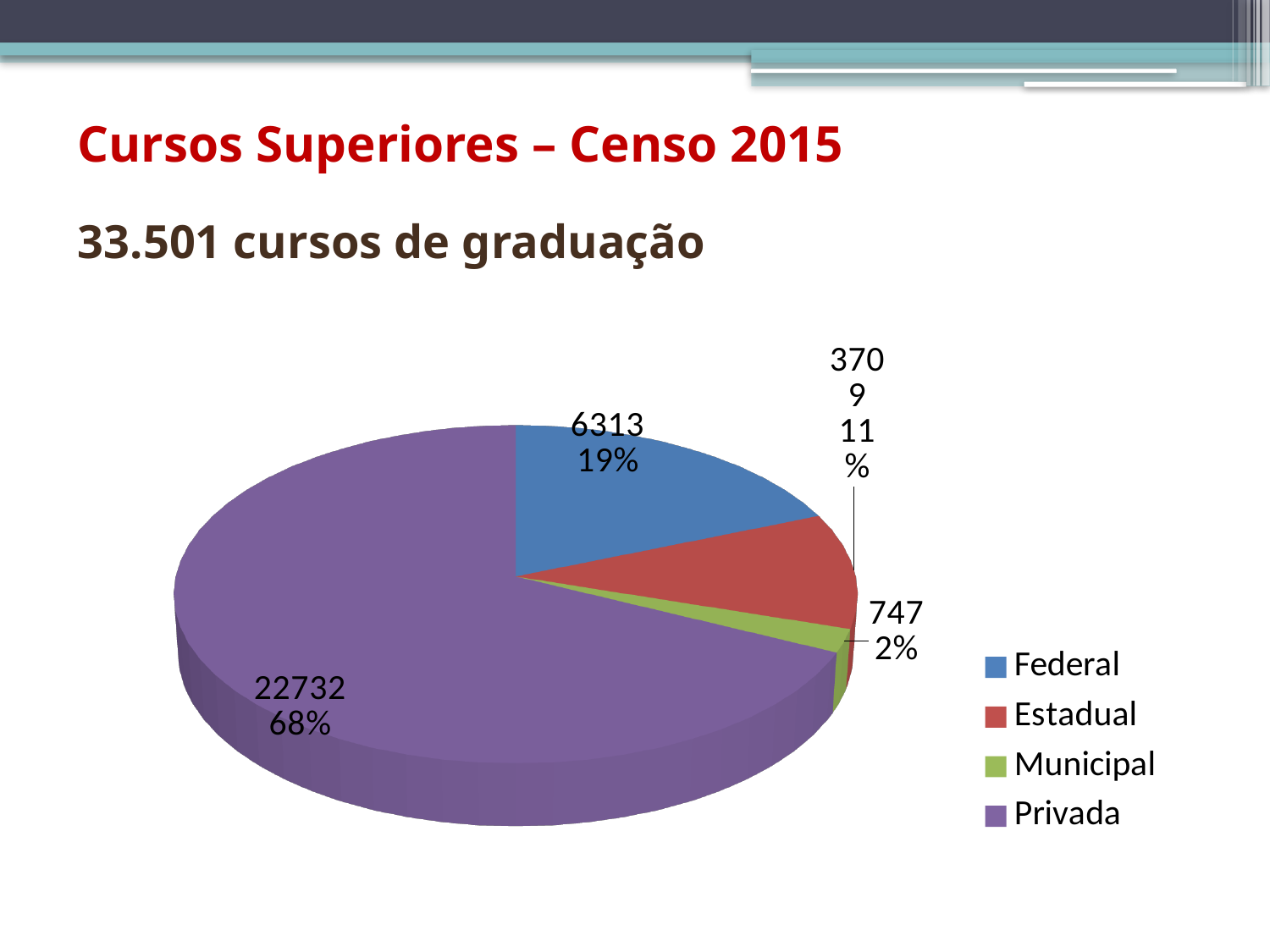
What percentage share does Privada have? 68% What is the difference between the values for Privada and Federal? 16419 What percentage share does Federal have? 19% What kind of chart is shown on the slide? pie chart What is the value shown for Federal? 6313 What is the value shown for Municipal? 747 Which colour represents Estadual in the legend? red How many slices does the pie chart have? 4 Which category has the smallest slice? Municipal How many entries does the legend list? 4 What is the value shown for Privada? 22732 Which category has the largest slice? Privada